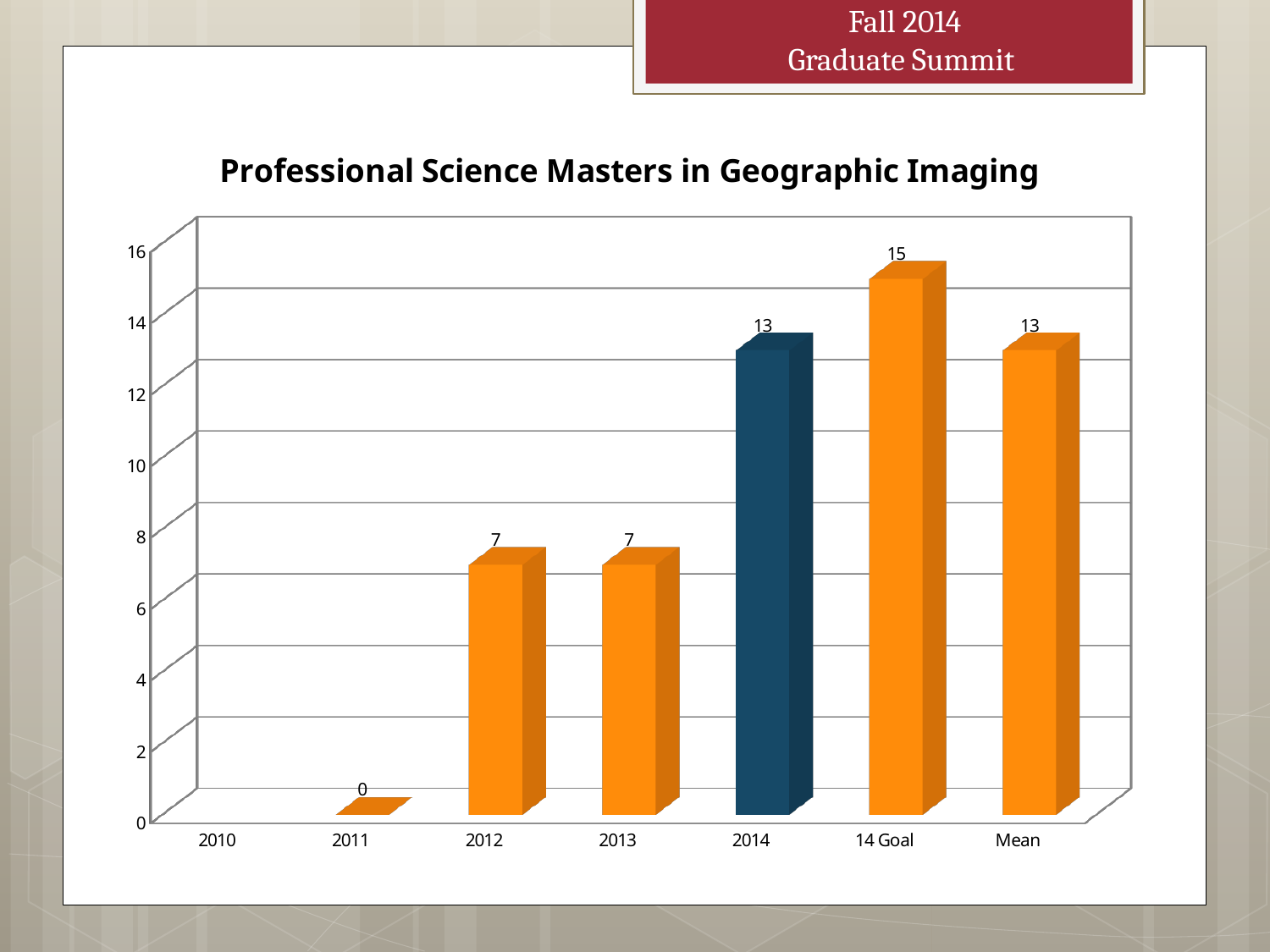
Is the value for 2014 greater or less than 10? greater Which is larger, the value for 2014 or the value for 2013? 2014 What is the difference between the 2014 value and the 2013 value? 6 What is the value for 2014? 13 Which category has the highest value? 14 Goal What is the value for 14 Goal? 15 How many categories are shown on the x axis? 7 What is the value for 2011? 0 What is the value for 2012? 7 What is the value for Mean? 13 What is the difference between the 14 Goal value and the 2014 value? 2 What kind of chart is shown on the slide? bar chart